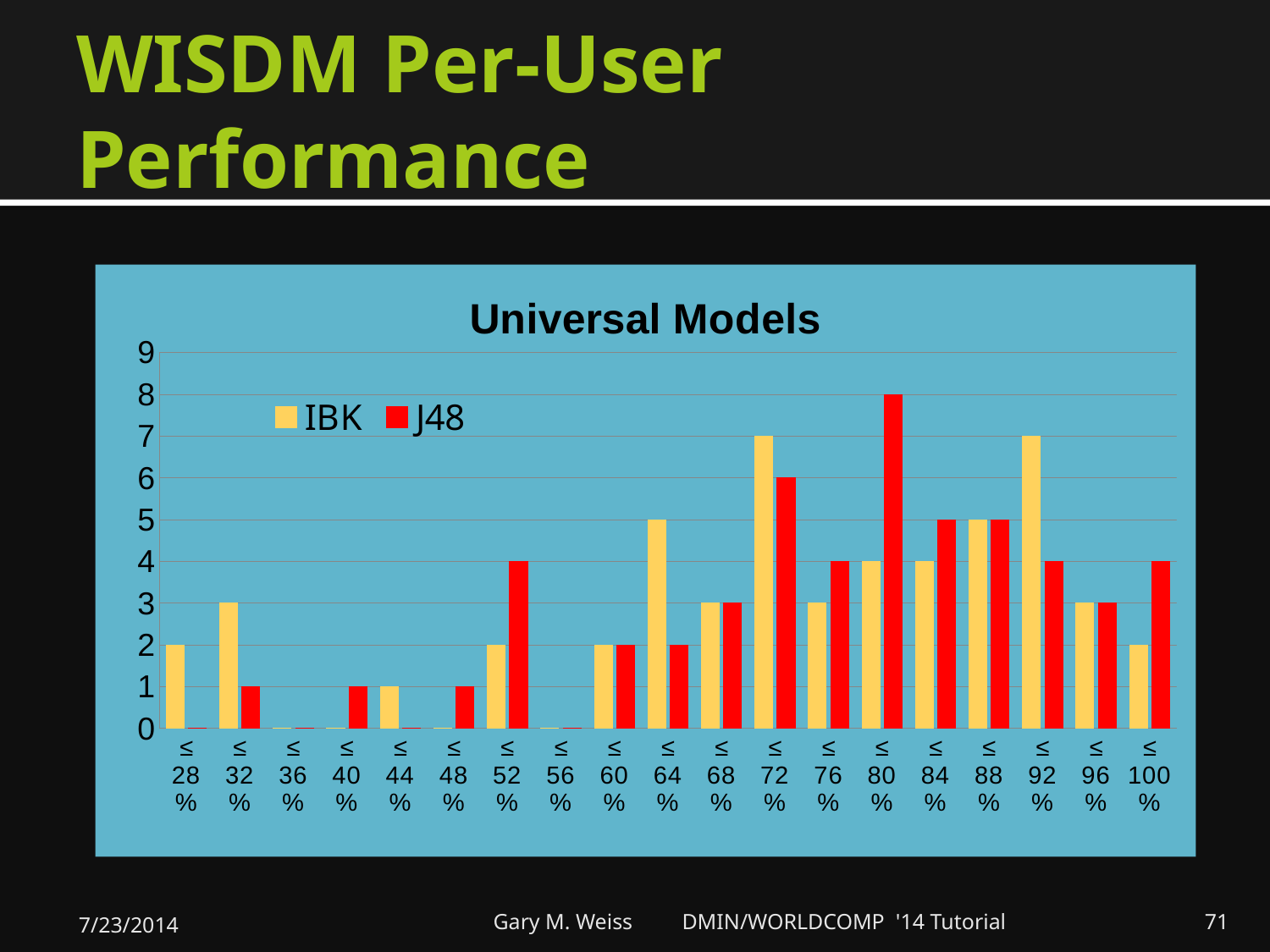
What is the IBK value for the ≤ 92% category? 7 For the ≤ 52% category, which series has the larger value, IBK or J48? J48 What is the IBK value for the ≤ 72% category? 7 What type of chart is shown on the slide? bar chart For the ≤ 64% category, which series has the larger value, IBK or J48? IBK What is the title of the chart? Universal Models How many categories are shown on the x axis? 19 How many series does the legend list? 2 What is the difference between the J48 and IBK values for the ≤ 80% category? 4 Which category has the highest J48 value? ≤ 80% Which colour represents the J48 series? red What is the J48 value for the ≤ 80% category? 8